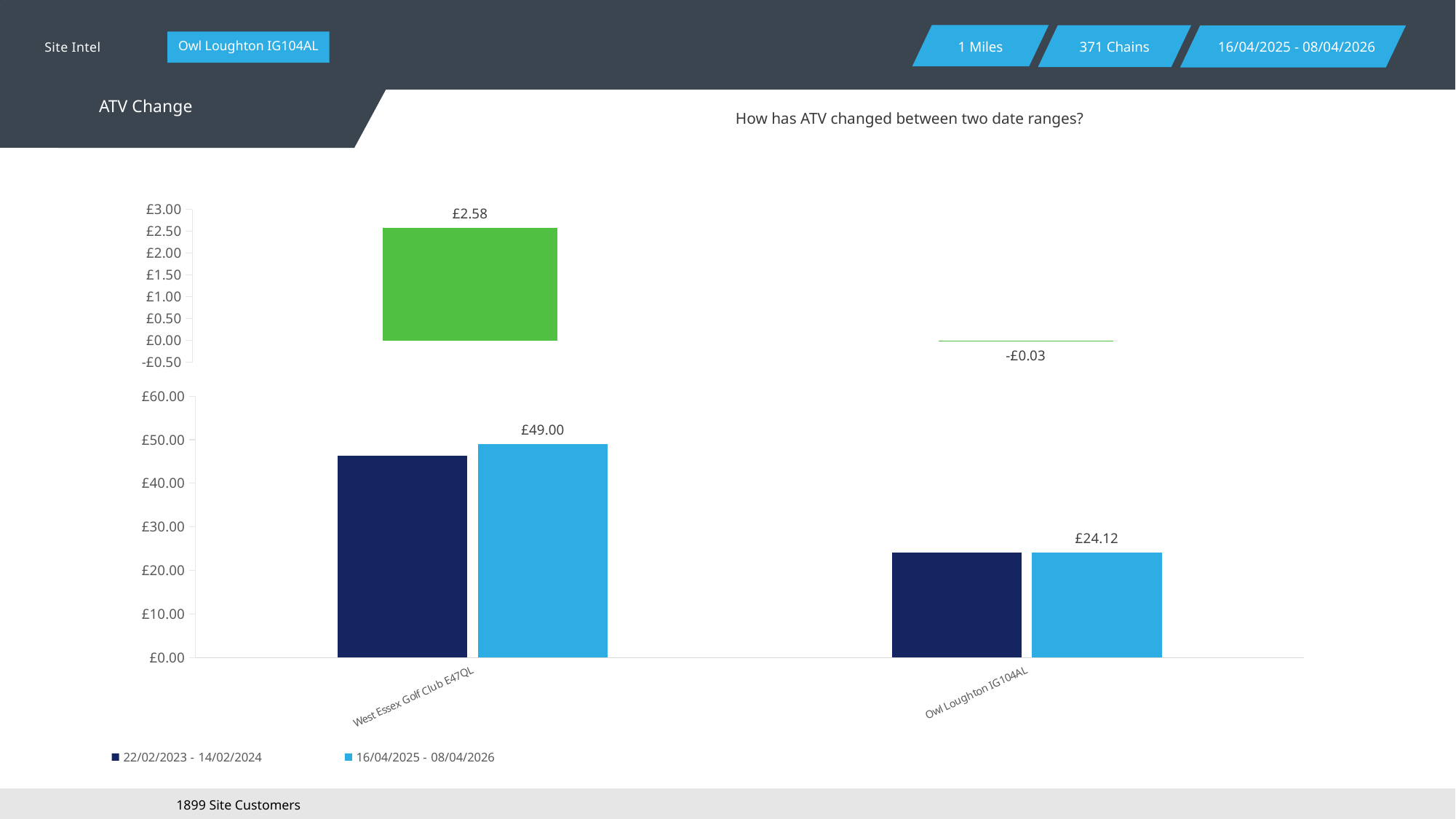
What type of chart is the bottom chart? Bar chart In the top chart, what value is labelled on the left green bar? £2.58 In the bottom chart, is the 22/02/2023 - 14/02/2024 value for West Essex Golf Club E47QL greater or less than £40.00? greater In the bottom chart, which category has the higher value in the 16/04/2025 - 08/04/2026 series? West Essex Golf Club E47QL In the bottom chart, what is the value for Owl Loughton IG104AL in the 16/04/2025 - 08/04/2026 series? £24.12 In the bottom chart, what is the value for West Essex Golf Club E47QL in the 16/04/2025 - 08/04/2026 series? £49.00 How many series does the legend of the bottom chart list? 2 In the bottom chart, is the 22/02/2023 - 14/02/2024 value for Owl Loughton IG104AL greater or less than £30.00? less In the top chart, what is the difference between the two labelled values, £2.58 and -£0.03? £2.61 In the top chart, is the left bar's value greater or less than £2.00? greater In the top chart, what value is labelled on the right-hand data point? -£0.03 In the bottom chart, what is the difference between the 16/04/2025 - 08/04/2026 values for West Essex Golf Club E47QL and Owl Loughton IG104AL? £24.88